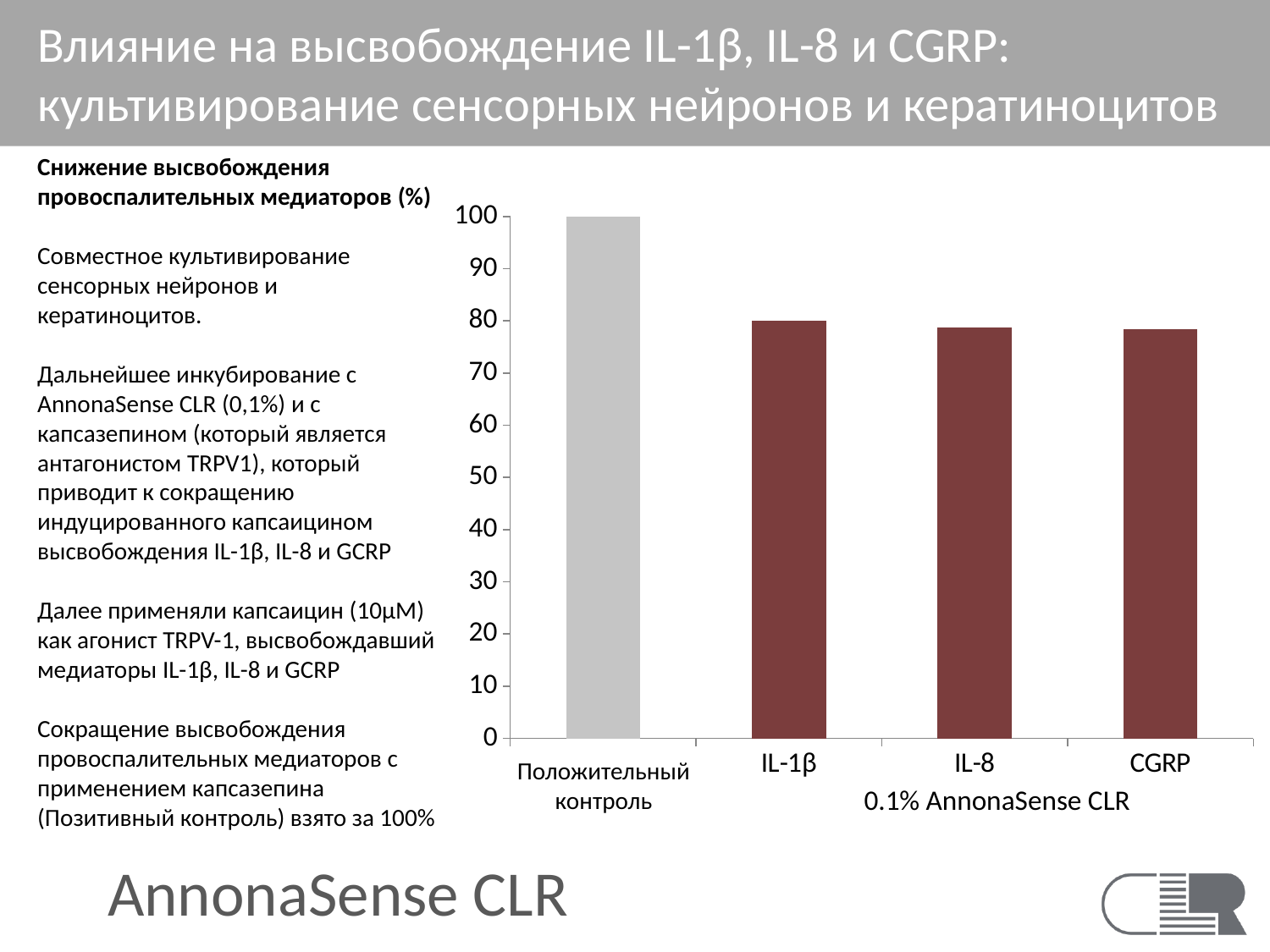
Which group label appears under the IL-1β, IL-8 and CGRP bars? 0.1% AnnonaSense CLR Which is larger, the value for Положительный контроль or the value for IL-1β? Положительный контроль How many bars are plotted in the chart? 4 Is the value for IL-8 greater or less than 70? greater What kind of chart is shown on the slide? bar chart Is the value for CGRP greater or less than 70? greater Is the value for IL-8 greater or less than 90? less What colour is the bar for Положительный контроль? grey Which category has the highest bar? Положительный контроль Which is larger, the value for Положительный контроль or the value for CGRP? Положительный контроль What is the value for Положительный контроль? 100